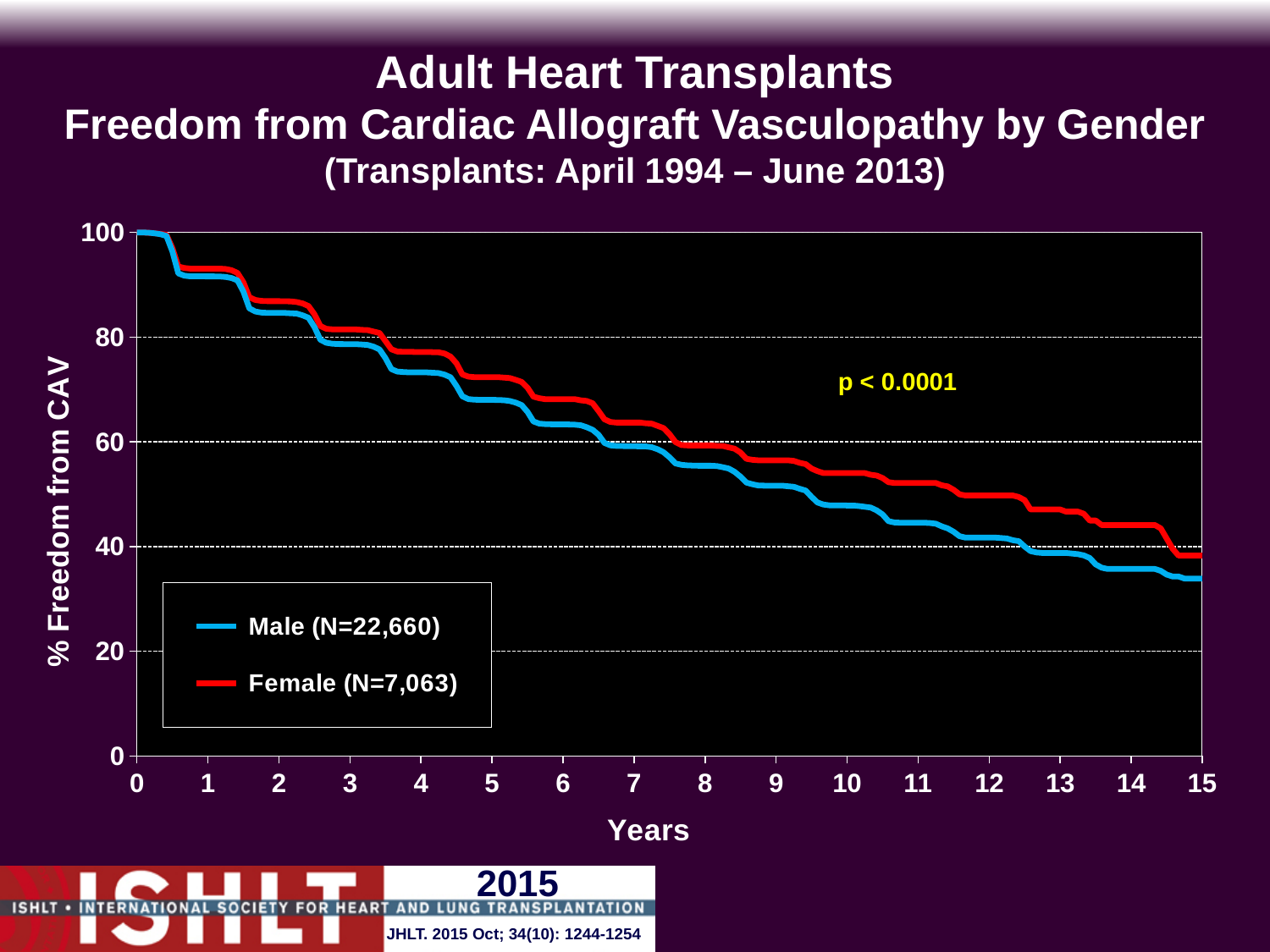
What is the % freedom from CAV for both series at year 0? 100 What p-value is printed on the chart? p < 0.0001 What kind of chart is shown on the slide? line chart What is the number of patients (N) given for the Male series in the legend? 22,660 Do the values for Male rise or fall as the years increase? fall Is the value for Female at year 10 greater or less than 40? greater Do the values for Female rise or fall as the years increase? fall At year 14, which series has the lower % freedom from CAV, Male or Female? Male How many series does the legend list? 2 At year 10, which series has the higher % freedom from CAV, Male or Female? Female Is the value for Male at year 5 greater or less than 60? greater Is the value for Male at year 15 greater or less than 40? less